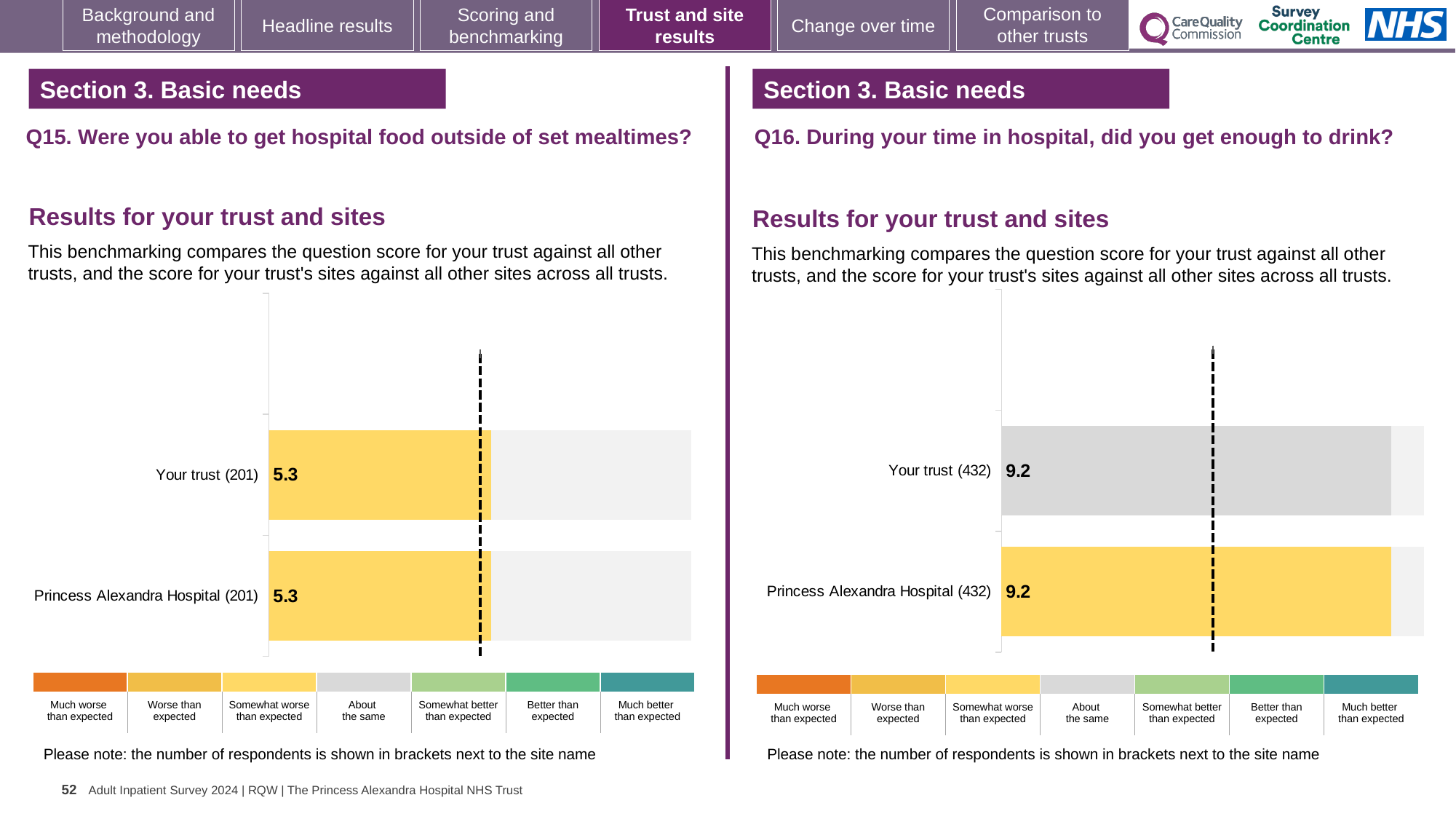
In the Q16 chart (right), what is the score for Your trust? 9.2 In the Q15 chart (left), how many respondents are shown in brackets next to Your trust? 201 What kind of chart is the Q15 chart on the left? Bar chart In the Q15 chart (left), which benchmarking category does the colour of the Princess Alexandra Hospital bar indicate? Somewhat worse than expected In the Q16 chart (right), which benchmarking category does the colour of the Your trust bar indicate? About the same In the Q16 chart (right), how many respondents are shown in brackets next to Princess Alexandra Hospital? 432 In the Q15 chart (left), what is the score for Your trust? 5.3 In the Q15 chart (left), what is the score for Princess Alexandra Hospital? 5.3 In the Q16 chart (right), what is the score for Princess Alexandra Hospital? 9.2 In the Q16 chart (right), how many bars are plotted? 2 Is the score for Your trust in the Q16 chart (right) larger or smaller than the score for Your trust in the Q15 chart (left)? Larger In the Q15 chart (left), what is the difference between the score for Your trust and the score for Princess Alexandra Hospital? 0.0